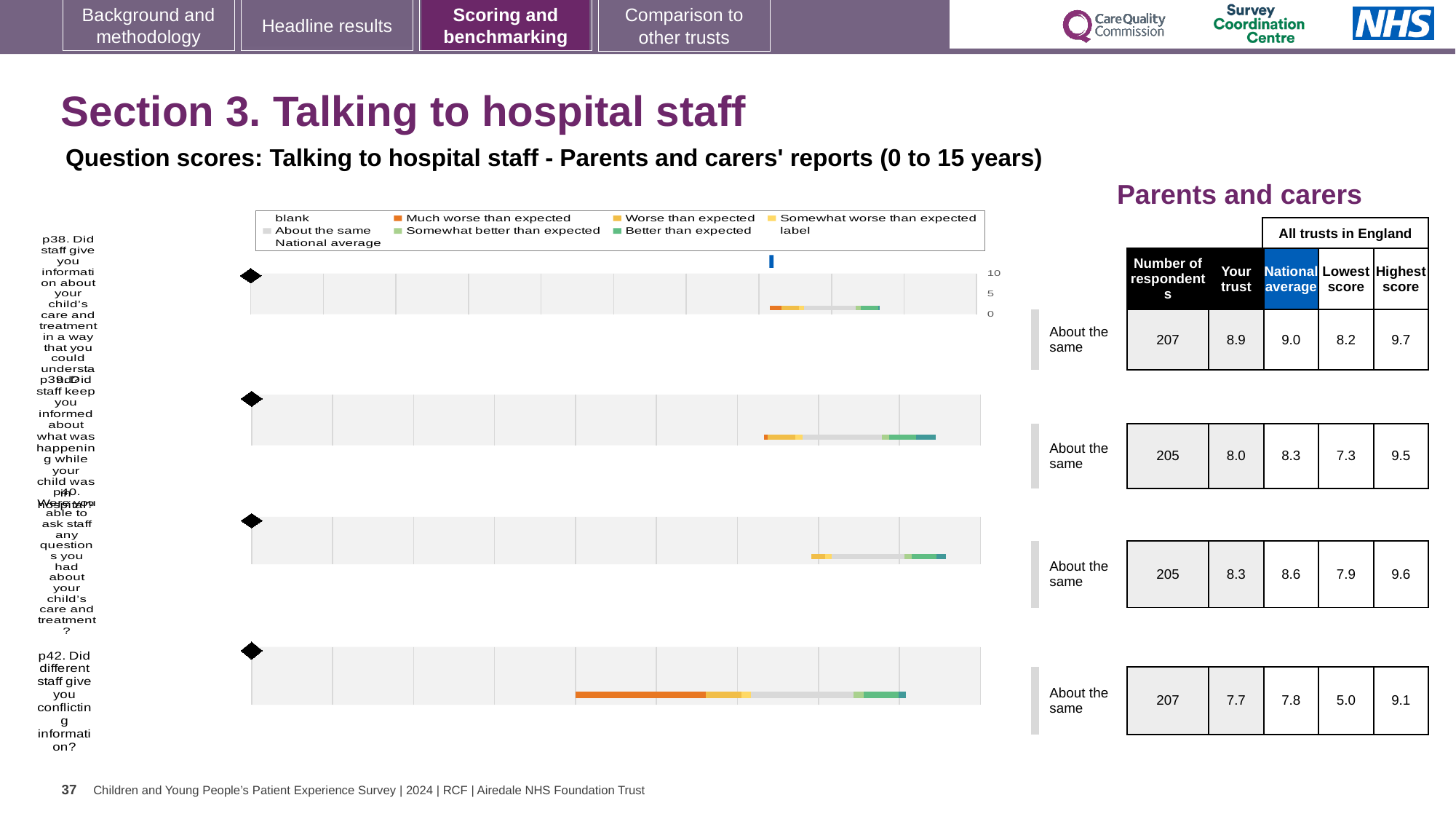
What is the Lowest score across all trusts in England for question p38? 8.2 What is the 'Your trust' score for question p38 (Did staff give you information about your child's care and treatment in a way that you could understand)? 8.9 Which question has the highest 'Your trust' score? p38 In the chart legend, which colour represents 'Much worse than expected'? orange How many respondents answered question p39 (Did staff keep you informed about what was happening while your child was in hospital)? 205 What is the National average score for question p42 (Did different staff give you conflicting information)? 7.8 What kind of chart is used to show the question scores on this slide? bar chart What is the difference between the Highest score and the Lowest score for question p42? 4.1 How many survey questions (rows) are plotted in the chart? 4 Which question has the lowest 'Your trust' score? p42 For question p40, which is larger: the 'Your trust' score or the National average? National average What benchmark category is shown for question p39? About the same